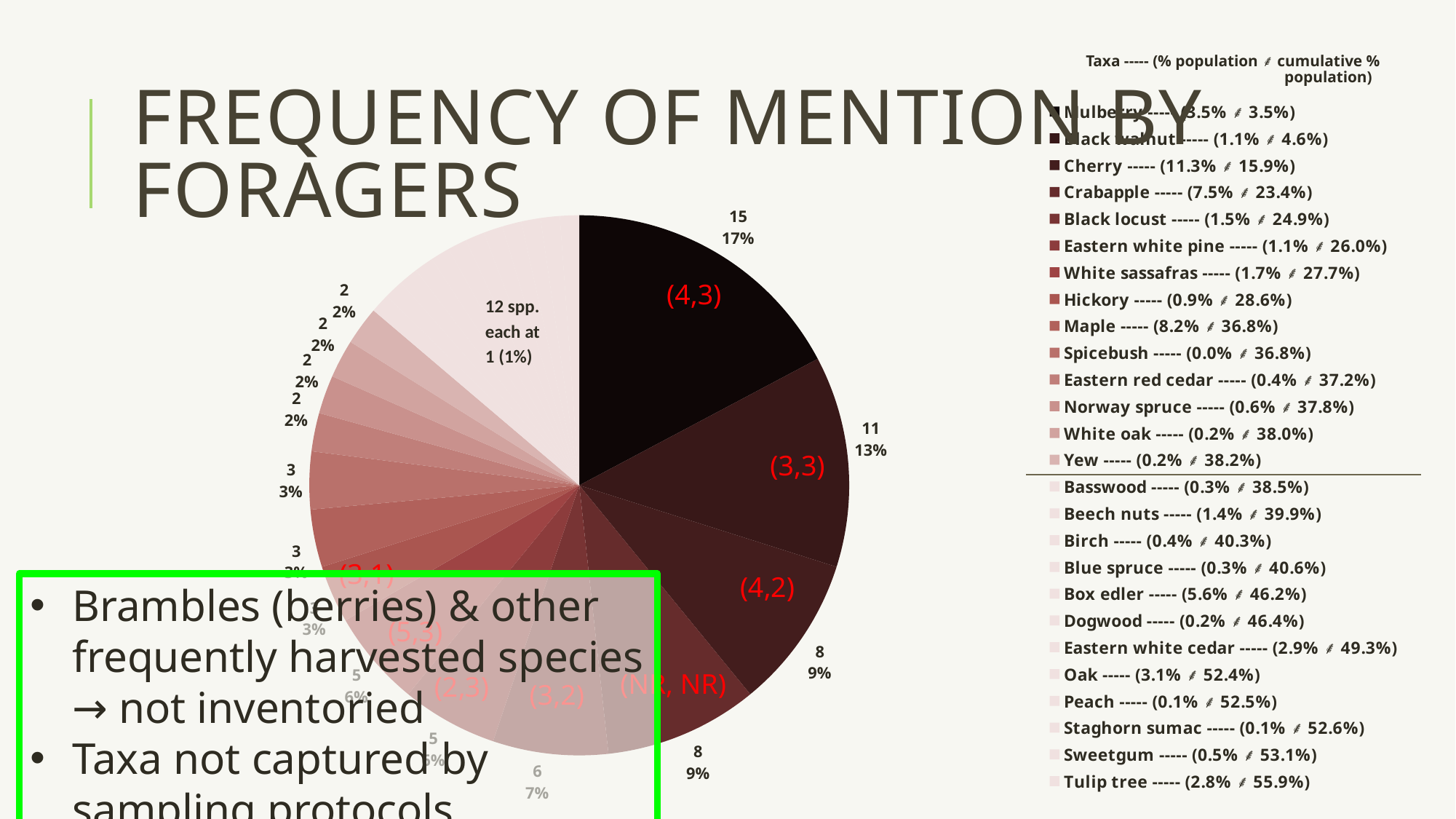
What does the label on the large light-pink slice of the pie say? 12 spp. each at 1 (1%) According to the legend, what is the % population for Cherry? 11.3% How many taxa are listed in the legend of the pie chart? 26 What share of the pie does the largest slice (the black one) represent? 17% What is the title of the slide's chart? Frequency of Mention by Foragers What count and percentage are shown on the largest slice of the pie chart? 15, 17% According to the legend, what is the cumulative % population for Tulip tree? 55.9% What type of chart is shown on the slide? pie chart What is the difference between the count on the largest slice (15) and the count on the second-largest slice (11)? 4 According to the legend, what is the % population for Maple? 8.2% Which is larger: the slice labelled 17% or the slice labelled 13%? the slice labelled 17% How many slices of the pie are labelled with a count of 2 (2%)? 4